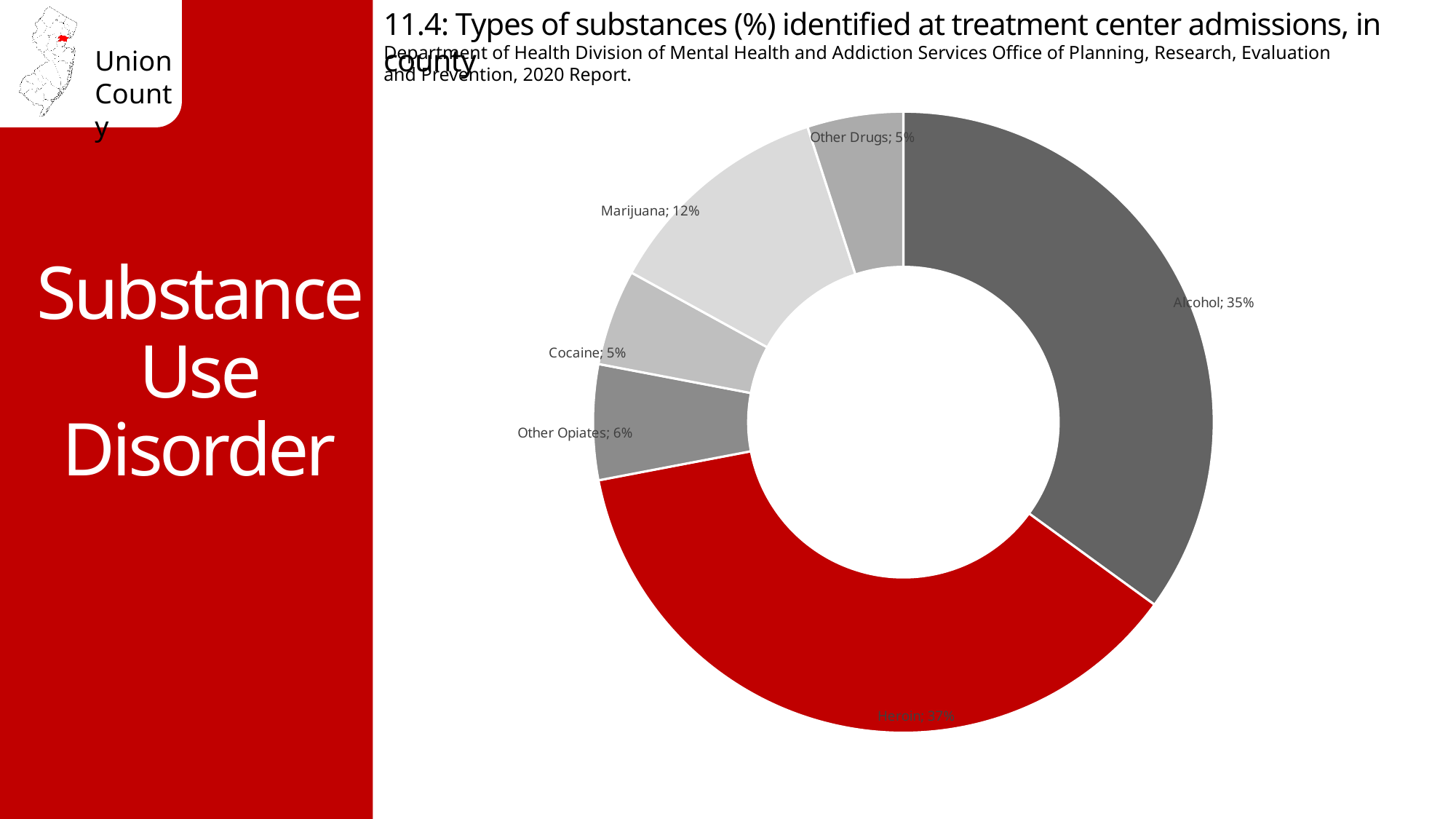
Which substance has the largest share of admissions? Heroin What percentage is shown for Marijuana? 12% What is the difference in percentage points between Heroin and Alcohol? 2 percentage points What percentage is shown for Cocaine? 5% How many substance categories are shown in the chart? 6 Which is larger, the share for Marijuana or the share for Other Opiates? Marijuana What is the difference in percentage points between Marijuana and Other Opiates? 6 percentage points What percentage is shown for Other Opiates? 6% What percentage is shown for Heroin? 37% Which slice of the chart is coloured red? Heroin What percentage of treatment center admissions is attributed to Alcohol? 35% What type of chart is shown on the slide? Pie chart (doughnut)